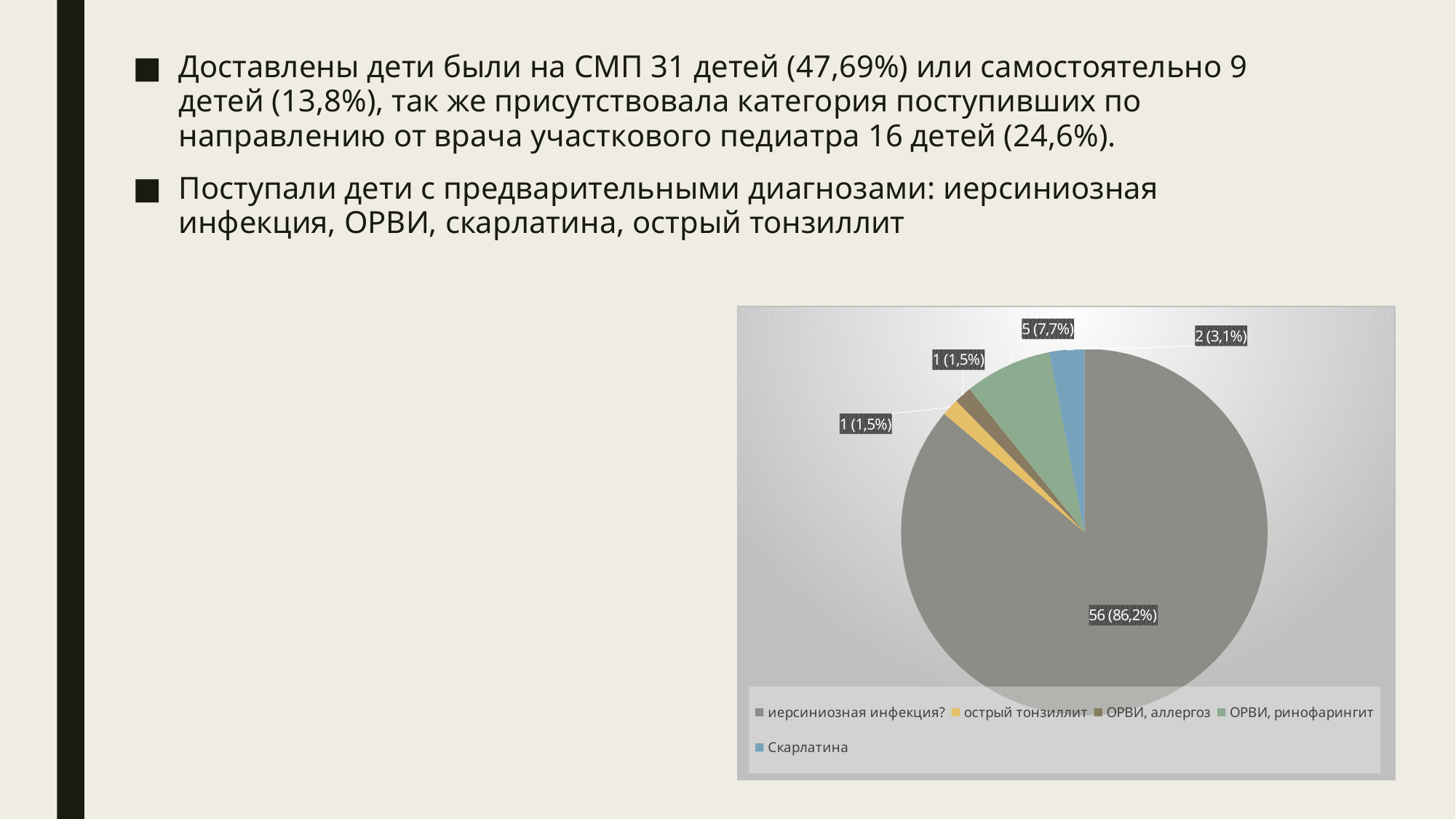
What is the data label for the 'Скарлатина' slice? 2 (3,1%) How many entries does the legend of the pie chart list? 5 How many slices does the pie chart have? 5 Which is larger, the 'Скарлатина' slice or the 'ОРВИ, ринофарингит' slice? ОРВИ, ринофарингит What is the data label for the 'иерсиниозная инфекция?' slice? 56 (86,2%) What kind of chart is shown on the slide? pie chart Which category has the largest slice of the pie? иерсиниозная инфекция? What is the data label for the 'ОРВИ, ринофарингит' slice? 5 (7,7%) What share of the pie does 'ОРВИ, ринофарингит' represent? 7,7% What is the difference in count between 'иерсиниозная инфекция?' and 'ОРВИ, ринофарингит'? 51 What is the total count across all slices of the pie chart? 65 What is the data label for the 'острый тонзиллит' slice? 1 (1,5%)